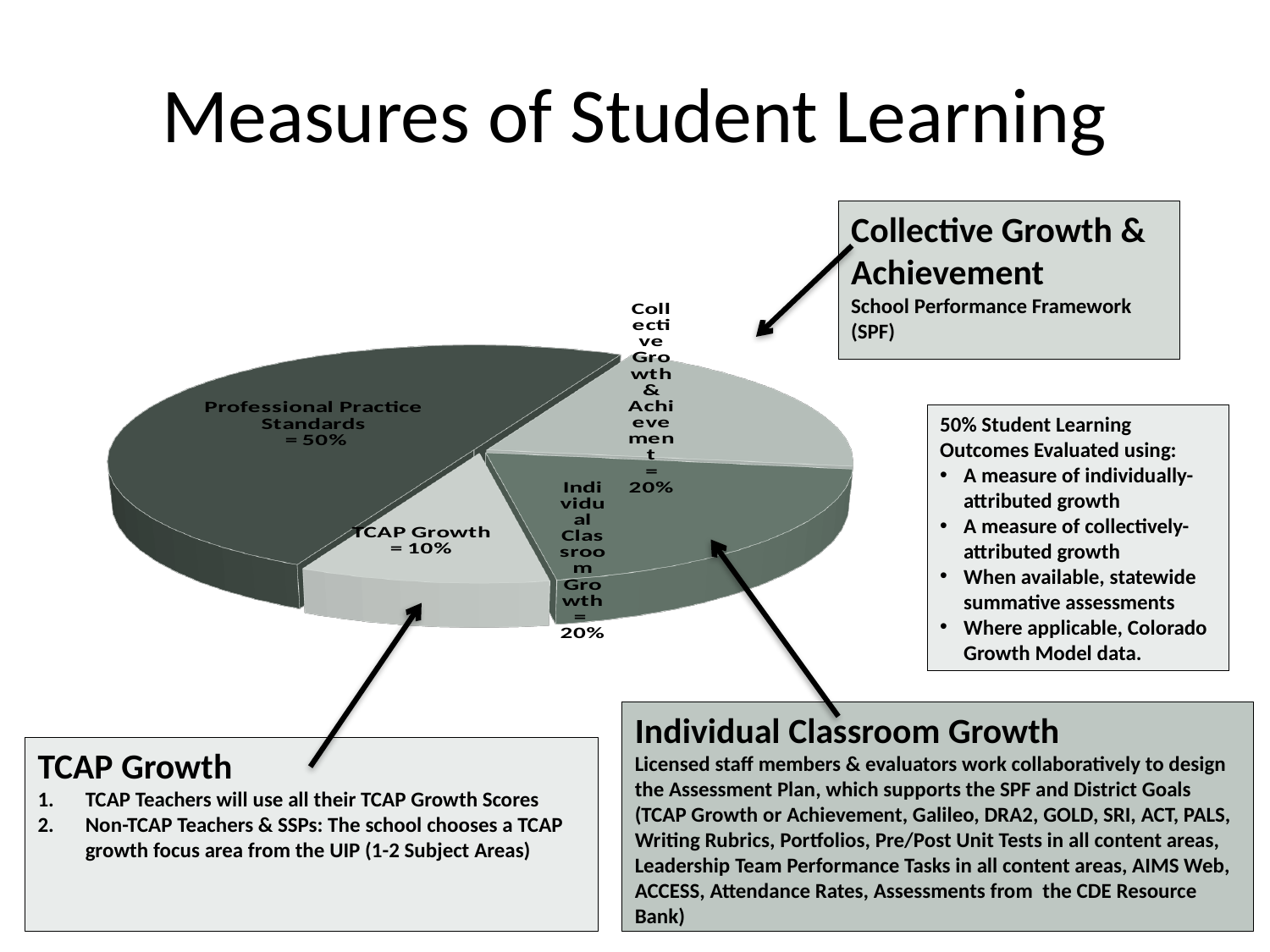
What percentage of the pie is Professional Practice Standards? 50% What percentage of the pie is TCAP Growth? 10% How many slices does the pie chart have? 4 Which slice of the pie chart is the smallest? TCAP Growth What percentage of the pie is Individual Classroom Growth? 20% What kind of chart is shown on the slide? pie chart Which slice of the pie chart is the largest? Professional Practice Standards What is the title of the slide containing the pie chart? Measures of Student Learning Which is larger, the Individual Classroom Growth slice or the TCAP Growth slice? Individual Classroom Growth What is the combined share of Individual Classroom Growth and Collective Growth & Achievement? 40% What percentage of the pie is Collective Growth & Achievement? 20% What is the difference in percentage points between Professional Practice Standards and TCAP Growth? 40